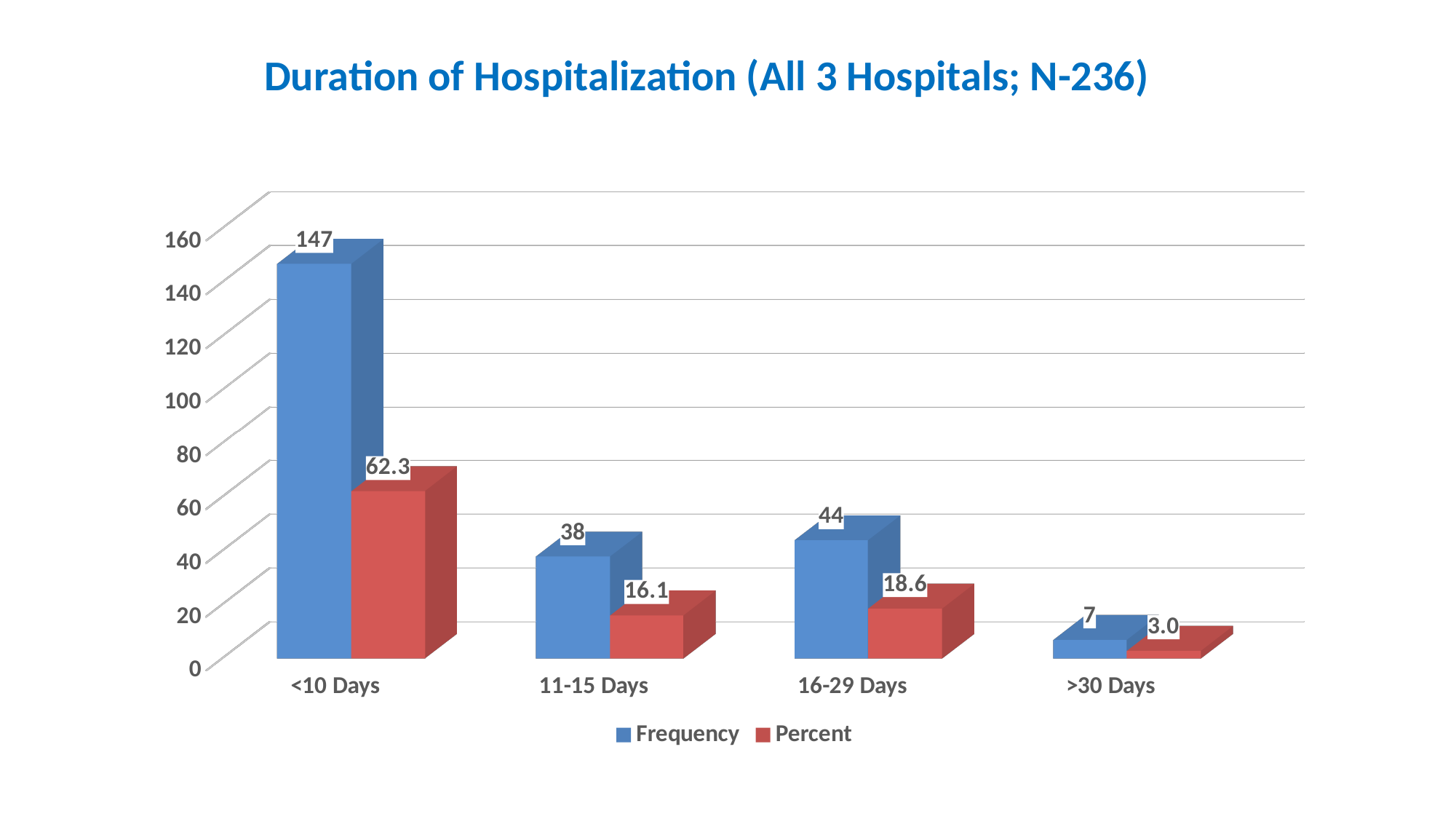
Which category has the highest Frequency? <10 Days What is the Frequency value for <10 Days? 147 Which is larger, the Frequency for 11-15 Days or the Frequency for 16-29 Days? 16-29 Days Which category has the lowest Percent? >30 Days What is the Percent value for 16-29 Days? 18.6 What kind of chart is shown on the slide? Bar chart What is the difference between the Frequency values for 16-29 Days and 11-15 Days? 6 What is the title of the chart? Duration of Hospitalization (All 3 Hospitals; N-236) How many series does the legend list? 2 What is the Percent value for 11-15 Days? 16.1 How many categories are shown on the x axis? 4 What is the Frequency value for >30 Days? 7